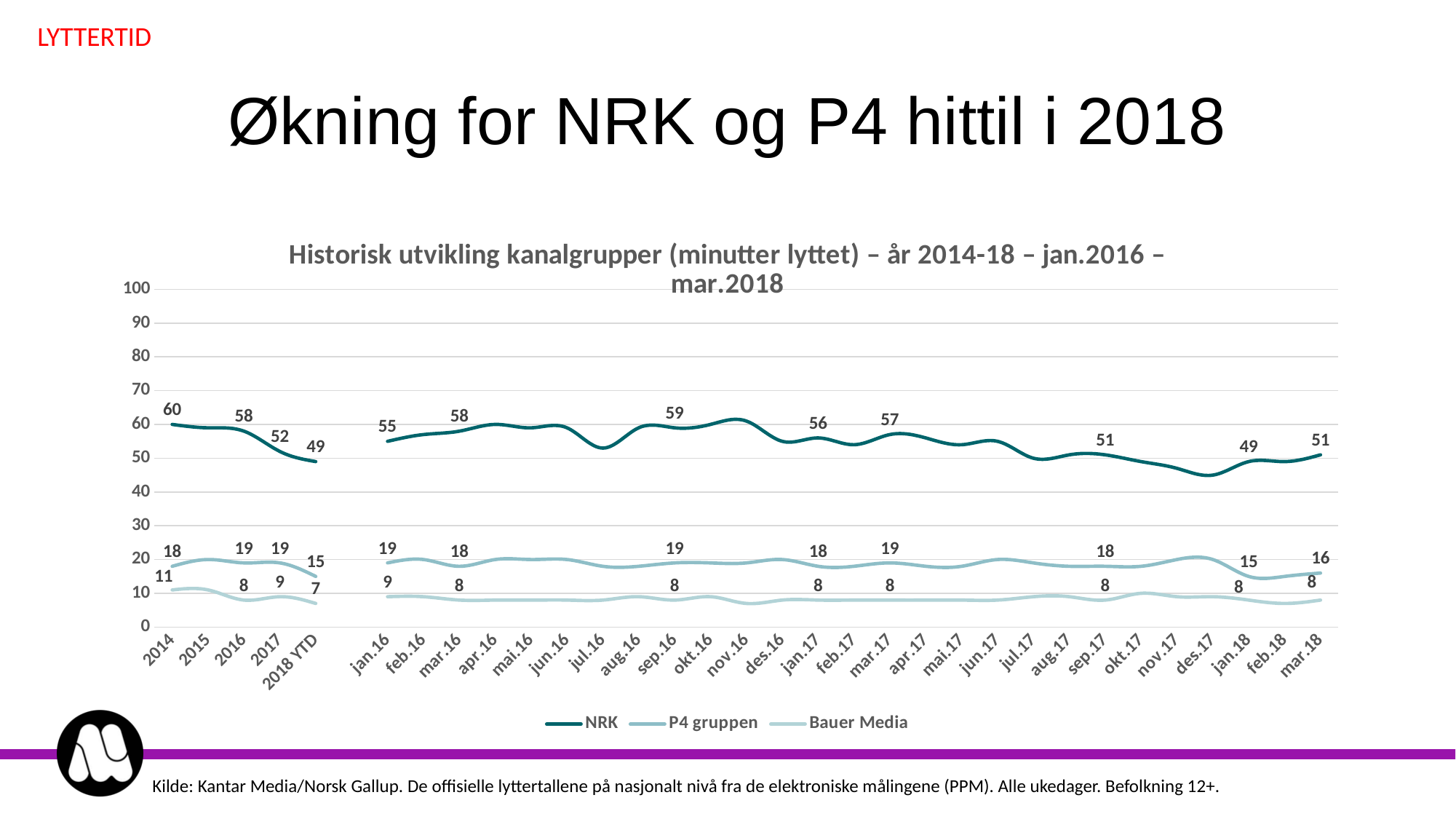
What is the value for NRK in 2014? 60 What is the value for NRK in 2018 YTD? 49 What is the value for P4 gruppen in jan.16? 19 What is the value for Bauer Media in 2014? 11 Is the value for NRK in des.17 greater or less than 50? less What is the difference between the NRK value in 2014 and in 2018 YTD? 11 Which series has the highest values throughout the chart? NRK How many series does the legend list? 3 What kind of chart is shown on the slide? line chart What is the value for Bauer Media in 2018 YTD? 7 Which is larger for NRK: the value in sep.16 or the value in jan.18? sep.16 What is the value for P4 gruppen in mar.18? 16